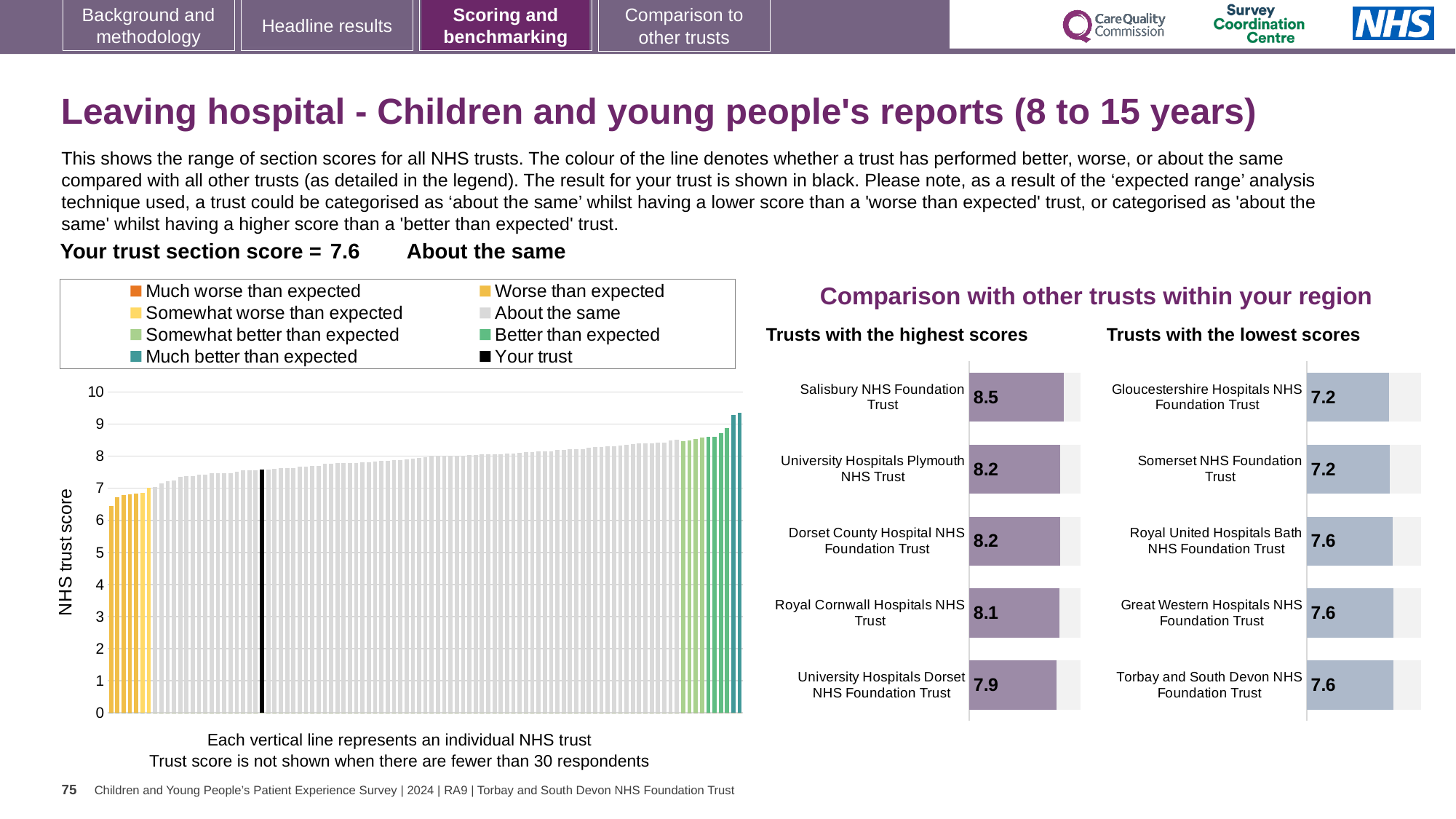
In the 'Trusts with the highest scores' chart, what is the difference between the scores of Salisbury NHS Foundation Trust and University Hospitals Dorset NHS Foundation Trust? 0.6 In the large chart on the left, is the value of the shortest bar greater or less than 7? less In the large chart on the left, do the bars rise or fall from left to right? rise In the 'Trusts with the highest scores' chart, what is the score for Salisbury NHS Foundation Trust? 8.5 In the 'Trusts with the lowest scores' chart, what is the score for Torbay and South Devon NHS Foundation Trust? 7.6 In the large chart on the left, is the value of the tallest bar greater or less than 9? greater How many trusts are shown in the 'Trusts with the lowest scores' chart? 5 How many entries does the legend above the large chart on the left list? 8 What kind of chart is the large chart on the left showing the range of NHS trust scores? bar chart In the large chart on the left, what is the label on the vertical axis? NHS trust score In the 'Trusts with the highest scores' chart, which trust has the lowest score? University Hospitals Dorset NHS Foundation Trust Which is larger: the score for Royal Cornwall Hospitals NHS Trust in the 'Trusts with the highest scores' chart or the score for Somerset NHS Foundation Trust in the 'Trusts with the lowest scores' chart? Royal Cornwall Hospitals NHS Trust